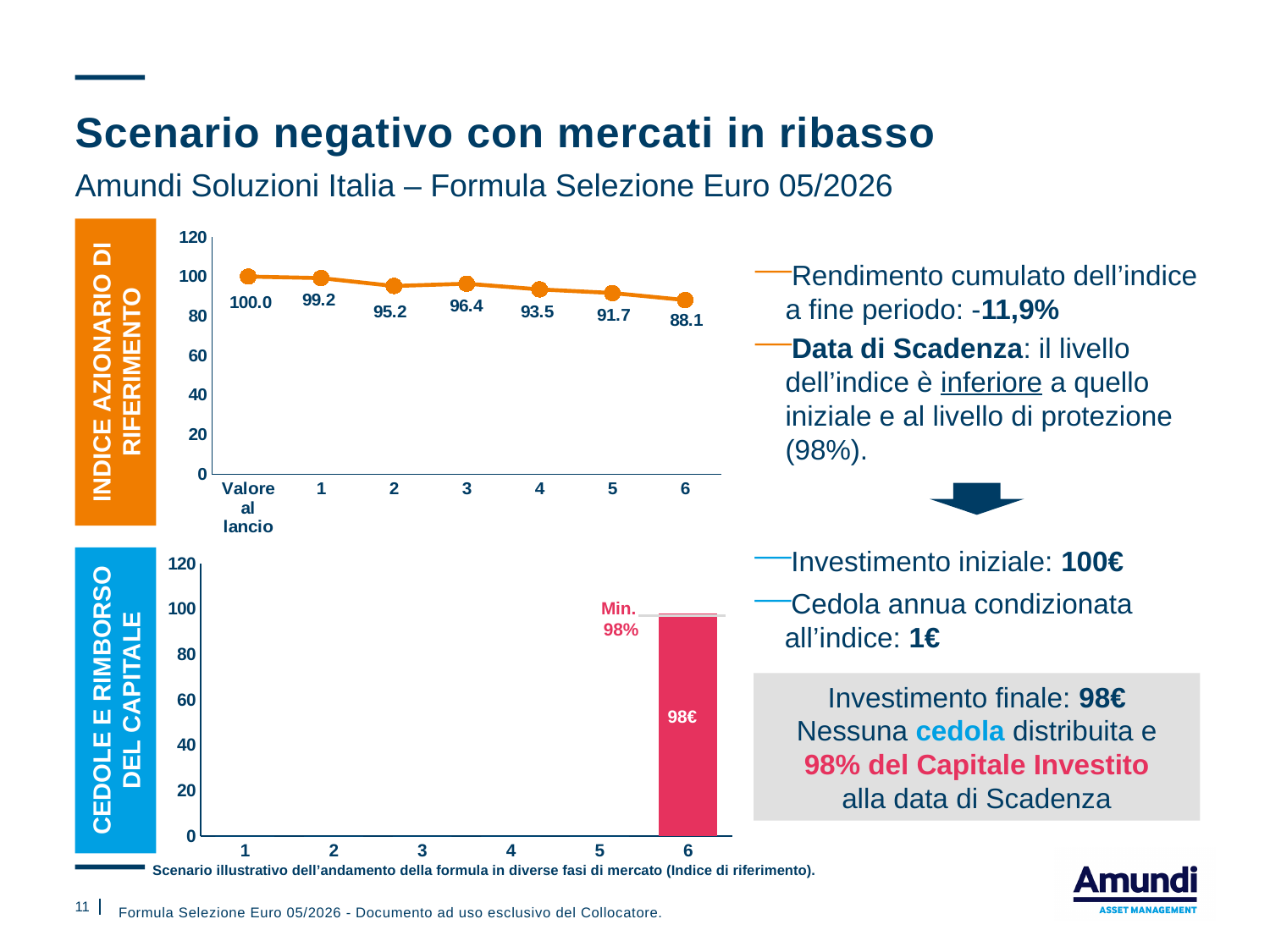
What kind of chart is the bottom chart (CEDOLE E RIMBORSO DEL CAPITALE)? Bar chart In the top chart (INDICE AZIONARIO DI RIFERIMENTO), what is the index value at 'Valore al lancio'? 100.0 In the top chart (INDICE AZIONARIO DI RIFERIMENTO), which point has the highest value? Valore al lancio In the top chart (INDICE AZIONARIO DI RIFERIMENTO), what is the index value at period 6? 88.1 In the top chart (INDICE AZIONARIO DI RIFERIMENTO), what is the difference between the value at 'Valore al lancio' and the value at period 6? 11.9 In the bottom chart (CEDOLE E RIMBORSO DEL CAPITALE), what is the value of the bar at period 6? 98€ What kind of chart is the top chart (INDICE AZIONARIO DI RIFERIMENTO)? Line chart In the top chart (INDICE AZIONARIO DI RIFERIMENTO), which is larger: the value at period 2 or the value at period 3? Period 3 In the top chart (INDICE AZIONARIO DI RIFERIMENTO), do the values generally rise or fall from 'Valore al lancio' to period 6? Fall In the top chart (INDICE AZIONARIO DI RIFERIMENTO), what is the index value at period 3? 96.4 In the top chart (INDICE AZIONARIO DI RIFERIMENTO), how many data points are plotted? 7 In the top chart (INDICE AZIONARIO DI RIFERIMENTO), at which period is the index value lowest? 6